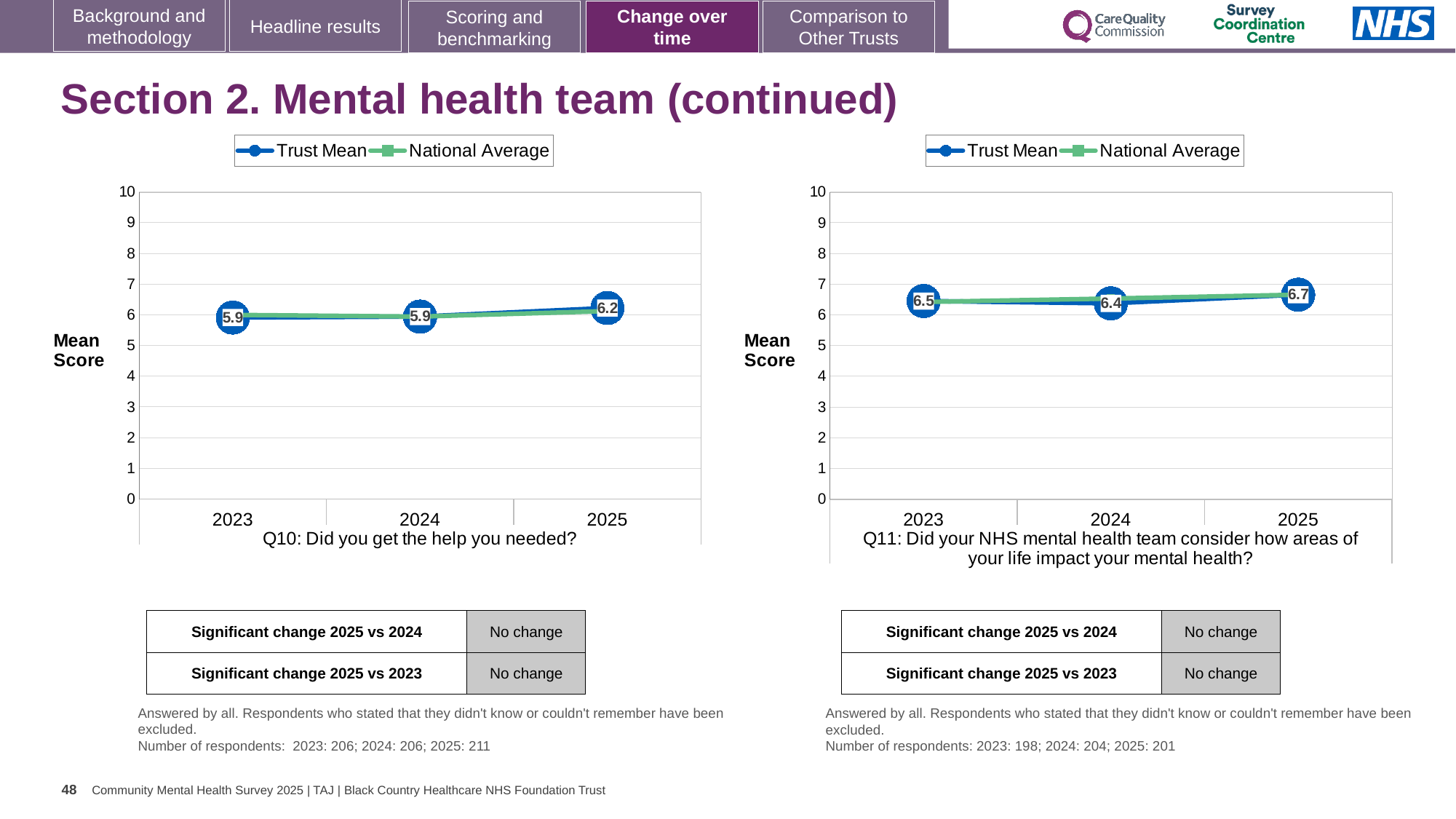
In the Q10 chart, what is the difference between the Trust Mean for 2025 and the Trust Mean for 2024? 0.3 In the Q10 chart, is the Trust Mean for 2024 greater or less than 7? less In the Q11 chart, what is the Trust Mean for 2025? 6.7 In the Q10 chart, what is the Trust Mean for 2023? 5.9 In the Q11 chart, what is the Trust Mean for 2024? 6.4 What kind of chart is the Q10 chart? Line chart How many years are plotted on the x axis of the Q10 chart? 3 In the Q10 chart, what is the Trust Mean for 2025? 6.2 In the Q11 chart, which year has the lowest Trust Mean? 2024 In the Q11 chart, which year has the highest Trust Mean? 2025 In the Q11 chart, is the Trust Mean for 2023 greater or less than 6? greater How many series does the legend of the Q11 chart list? 2